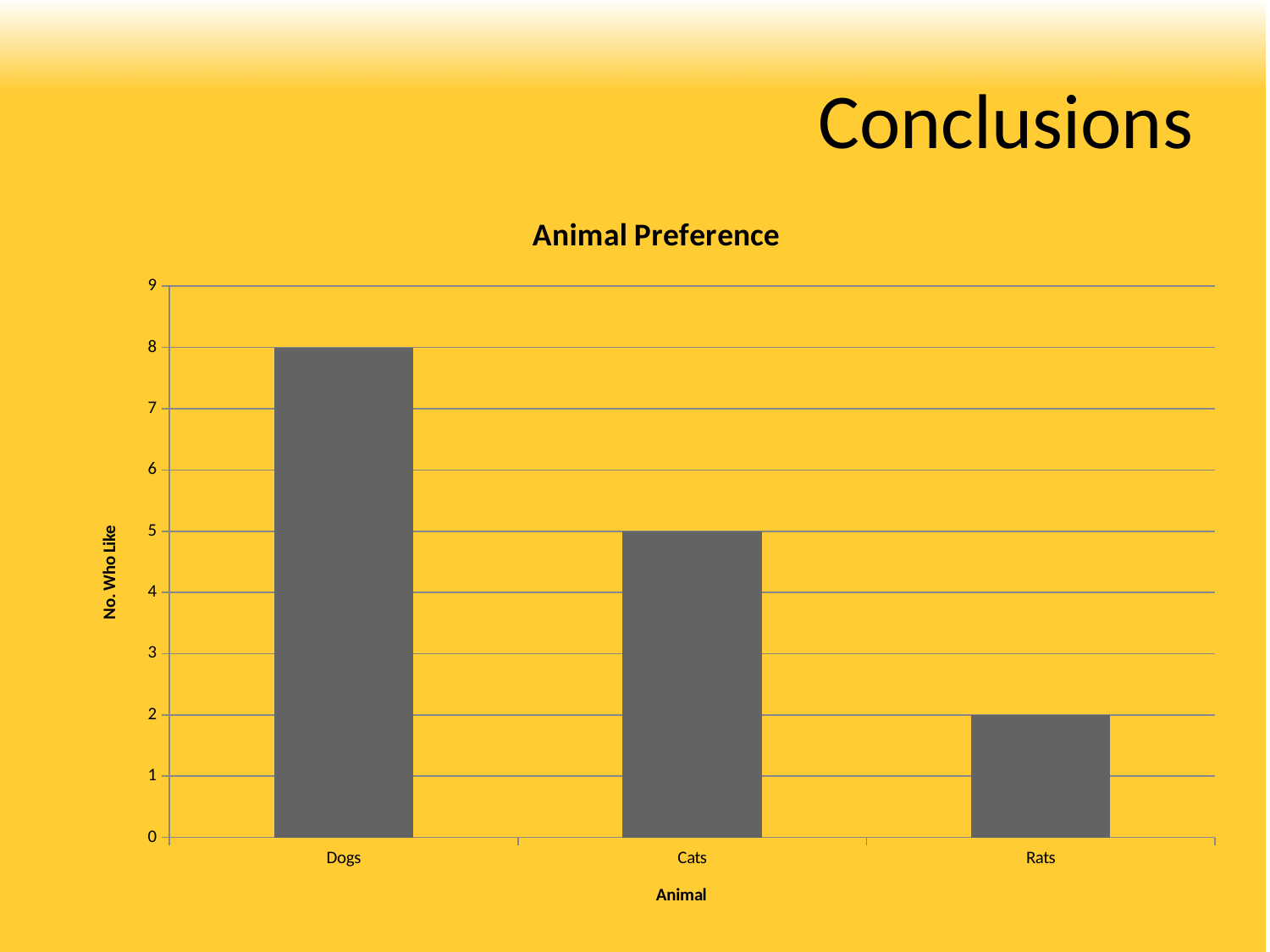
Which animal has the highest value in the Animal Preference chart? Dogs What is the value for Rats in the Animal Preference chart? 2 What is the value for Dogs in the Animal Preference chart? 8 What is the label of the vertical axis of the chart? No. Who Like What is the value for Cats in the Animal Preference chart? 5 What kind of chart is shown on the slide? bar chart What is the difference between the values for Cats and Rats? 3 What is the difference between the values for Dogs and Cats? 3 Which is larger, the value for Cats or the value for Rats? Cats Is the value for Dogs greater or less than 6? greater Which animal has the lowest value in the Animal Preference chart? Rats How many animal categories are shown in the chart? 3